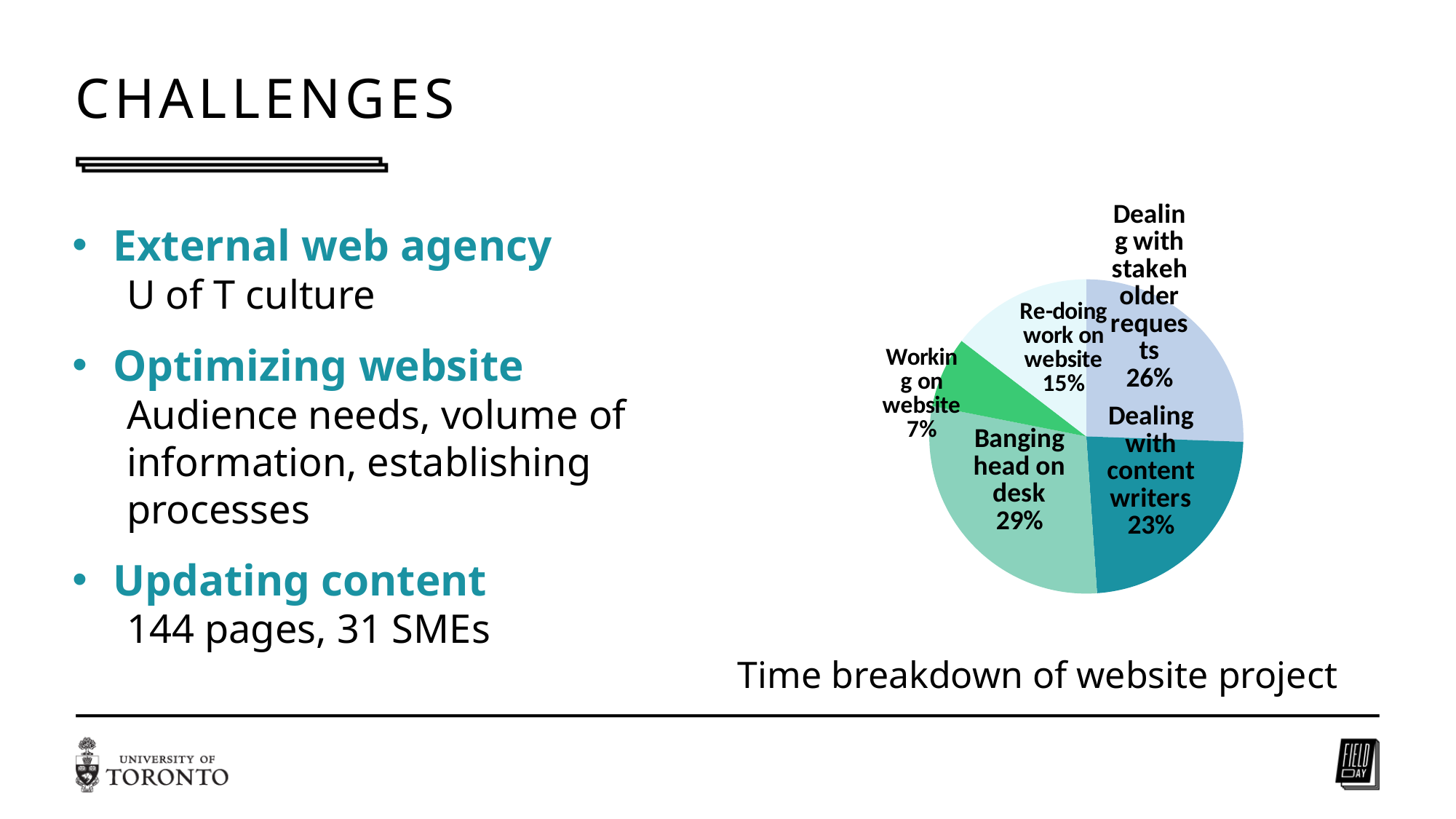
What is the caption below the pie chart? Time breakdown of website project Which slice of the pie chart is the smallest? Working on website What kind of chart is shown on the slide? pie chart What share of time is labelled for "Banging head on desk"? 29% Which is larger: "Dealing with stakeholder requests" or "Re-doing work on website"? Dealing with stakeholder requests What share of time is labelled for "Dealing with stakeholder requests"? 26% What is the difference in percentage points between "Banging head on desk" and "Working on website"? 22 How many slices does the pie chart have? 5 What share of time is labelled for "Dealing with content writers"? 23% What share of time is labelled for "Re-doing work on website"? 15% Which slice of the pie chart is the largest? Banging head on desk What share of time is labelled for "Working on website"? 7%